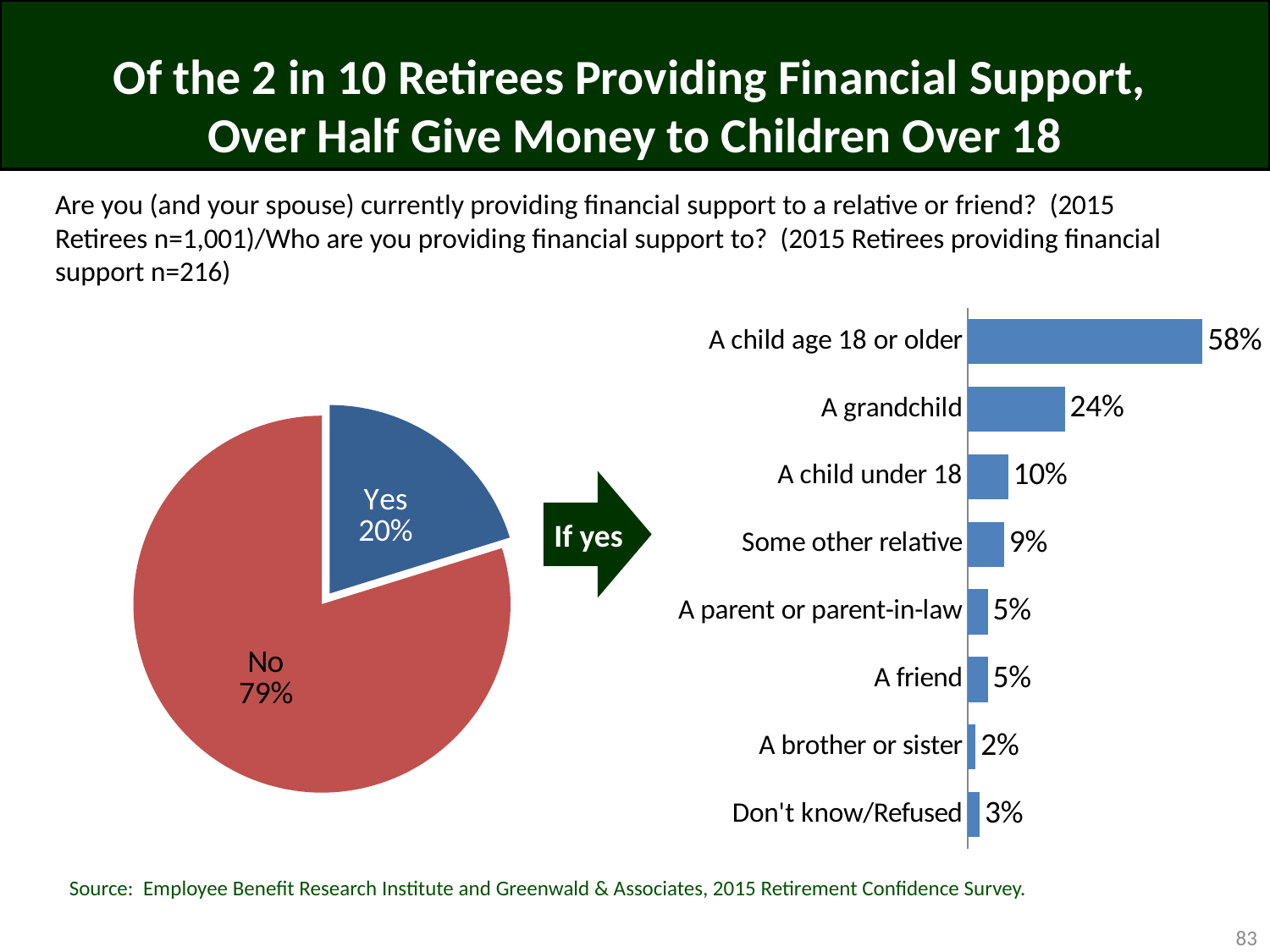
What kind of chart is the chart on the left of the slide? Pie chart In the bar chart on the right, which category has the highest value? A child age 18 or older In the bar chart on the right, what is the value for Some other relative? 9% In the bar chart on the right, which is larger, the value for A child under 18 or the value for Don't know/Refused? A child under 18 What kind of chart is the chart on the right of the slide? Bar chart In the pie chart on the left, what share of retirees answered Yes? 20% In the bar chart on the right, what is the difference between the values for A child age 18 or older and A grandchild? 34% In the bar chart on the right, which category has the lowest value? A brother or sister In the pie chart on the left, which slice is larger, Yes or No? No In the pie chart on the left, what share of retirees answered No? 79% How many categories are shown in the bar chart on the right? 8 In the bar chart on the right, what is the value for A grandchild? 24%